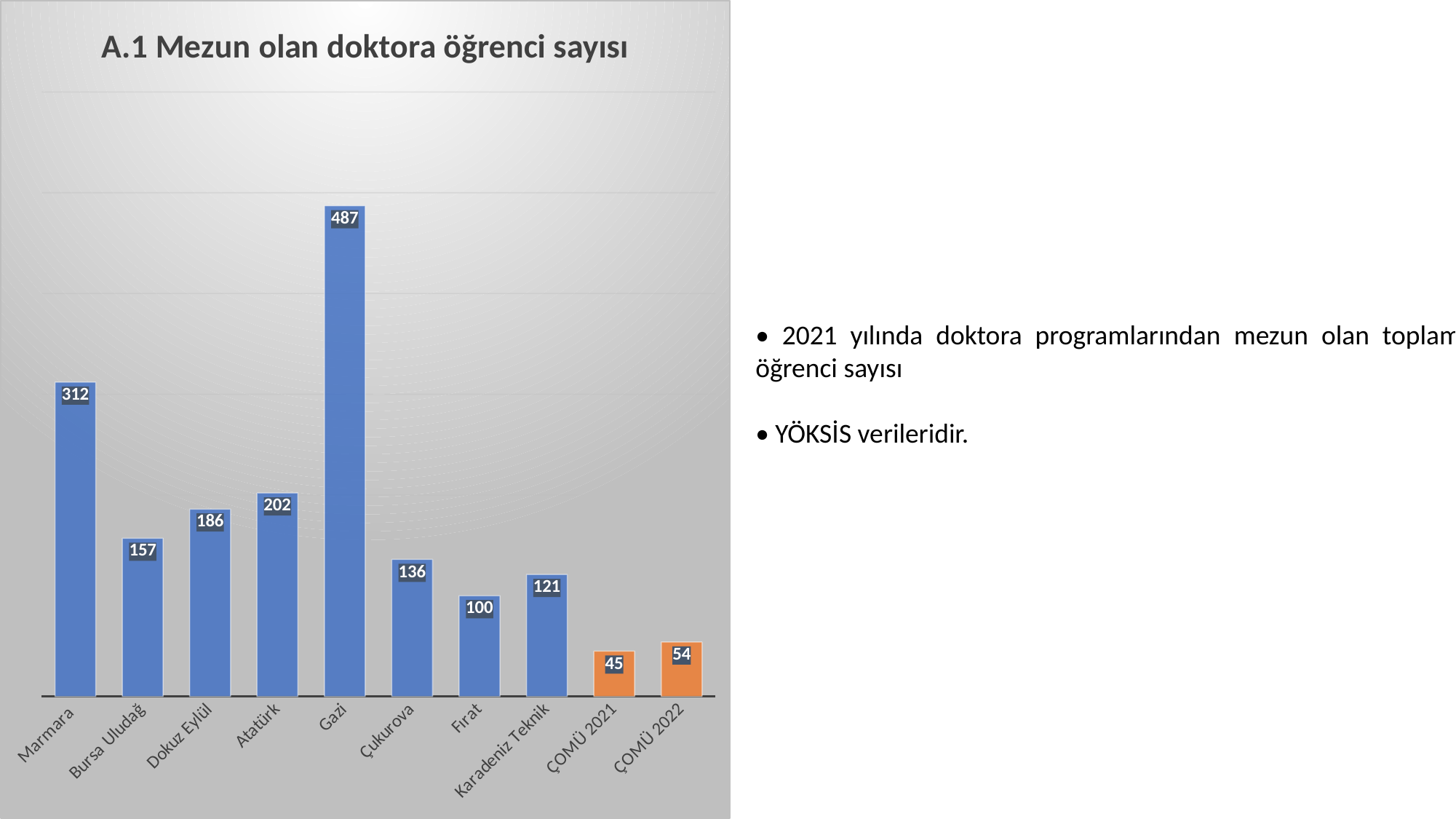
Which category has the highest value? Gazi What is the difference between the values for Gazi and Marmara? 175 What kind of chart is shown on the slide? Bar chart What is the title of the chart? A.1 Mezun olan doktora öğrenci sayısı How many categories are shown on the x axis? 10 What is the value for ÇOMÜ 2022? 54 What is the difference between the values for ÇOMÜ 2022 and ÇOMÜ 2021? 9 What is the value for Gazi? 487 What is the value for Marmara? 312 Which category has the lowest value? ÇOMÜ 2021 Which is larger, the value for Dokuz Eylül or the value for Bursa Uludağ? Dokuz Eylül What is the value for Karadeniz Teknik? 121